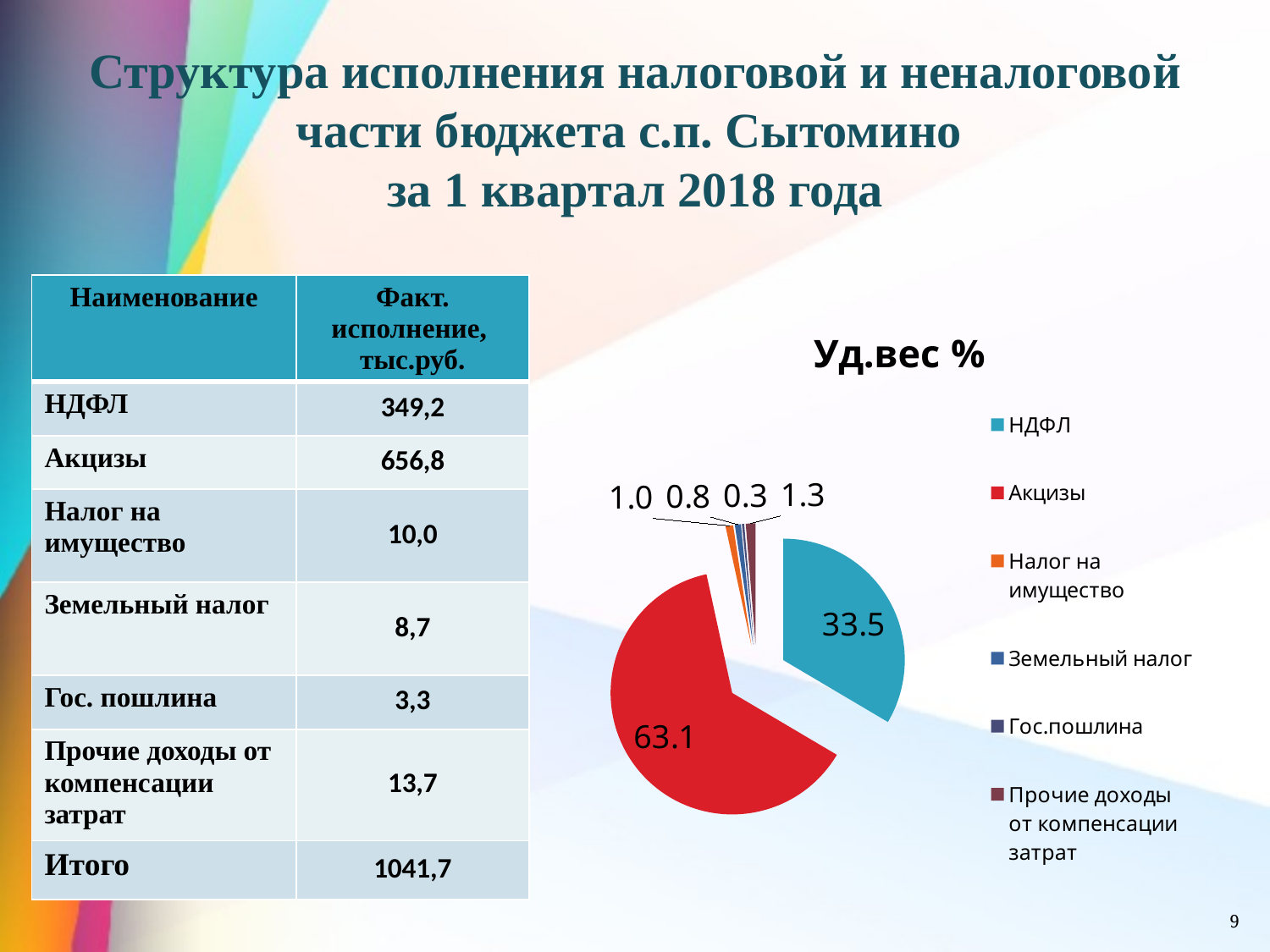
What is the title of the pie chart? Уд.вес % What kind of chart is shown on the slide? pie chart What share does Прочие доходы от компенсации затрат have in the pie chart? 1.3 What share does НДФЛ have in the pie chart? 33.5 What is the difference between the shares of Акцизы and НДФЛ in the pie chart? 29.6 Which category has the largest slice in the pie chart? Акцизы What share does Акцизы have in the pie chart? 63.1 How many categories does the pie chart's legend list? 6 Which is larger in the pie chart, НДФЛ or Акцизы? Акцизы What share does Гос.пошлина have in the pie chart? 0.3 Which category has the smallest slice in the pie chart? Гос.пошлина What colour is the НДФЛ slice in the pie chart? blue